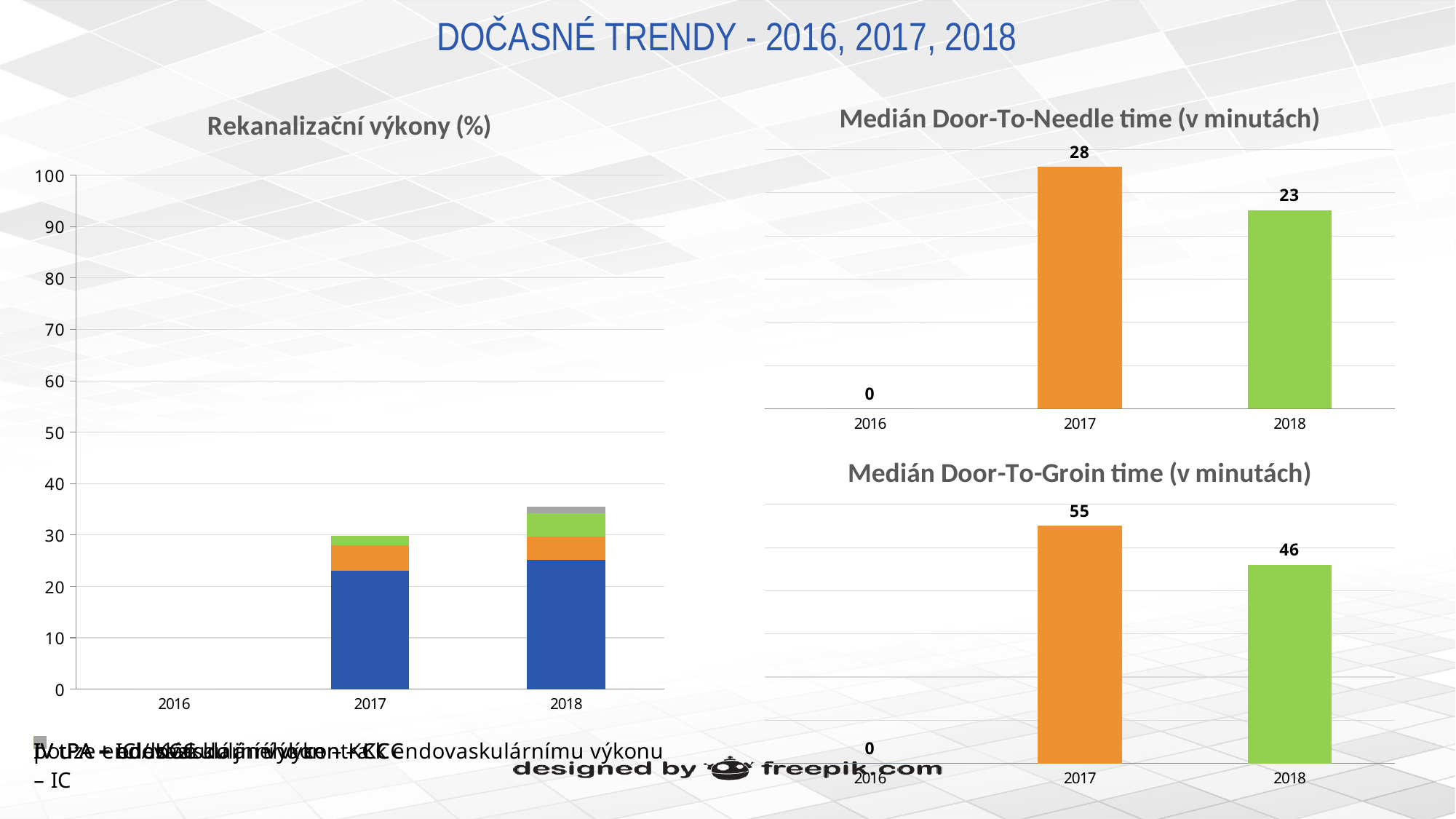
In the Medián Door-To-Needle time chart, what is the difference between the 2017 and 2018 values? 5 In the Medián Door-To-Needle time chart, is the value for 2017 or 2018 larger? 2017 In the Medián Door-To-Needle time chart, what is the value for 2017? 28 In the Medián Door-To-Groin time chart, what is the value shown for 2016? 0 In the Medián Door-To-Groin time chart, what is the value for 2017? 55 What kind of chart is the Medián Door-To-Needle time chart? bar chart In the Medián Door-To-Groin time chart, which year has the highest value? 2017 In the Rekanalizační výkony (%) chart, is the total of the stacked bar for 2018 greater or less than 40? less In the Medián Door-To-Groin time chart, what is the difference between the 2017 and 2018 values? 9 How many years are shown on the x axis of the Rekanalizační výkony (%) chart? 3 In the Medián Door-To-Needle time chart, what is the value for 2018? 23 In the Medián Door-To-Groin time chart, what is the value for 2018? 46